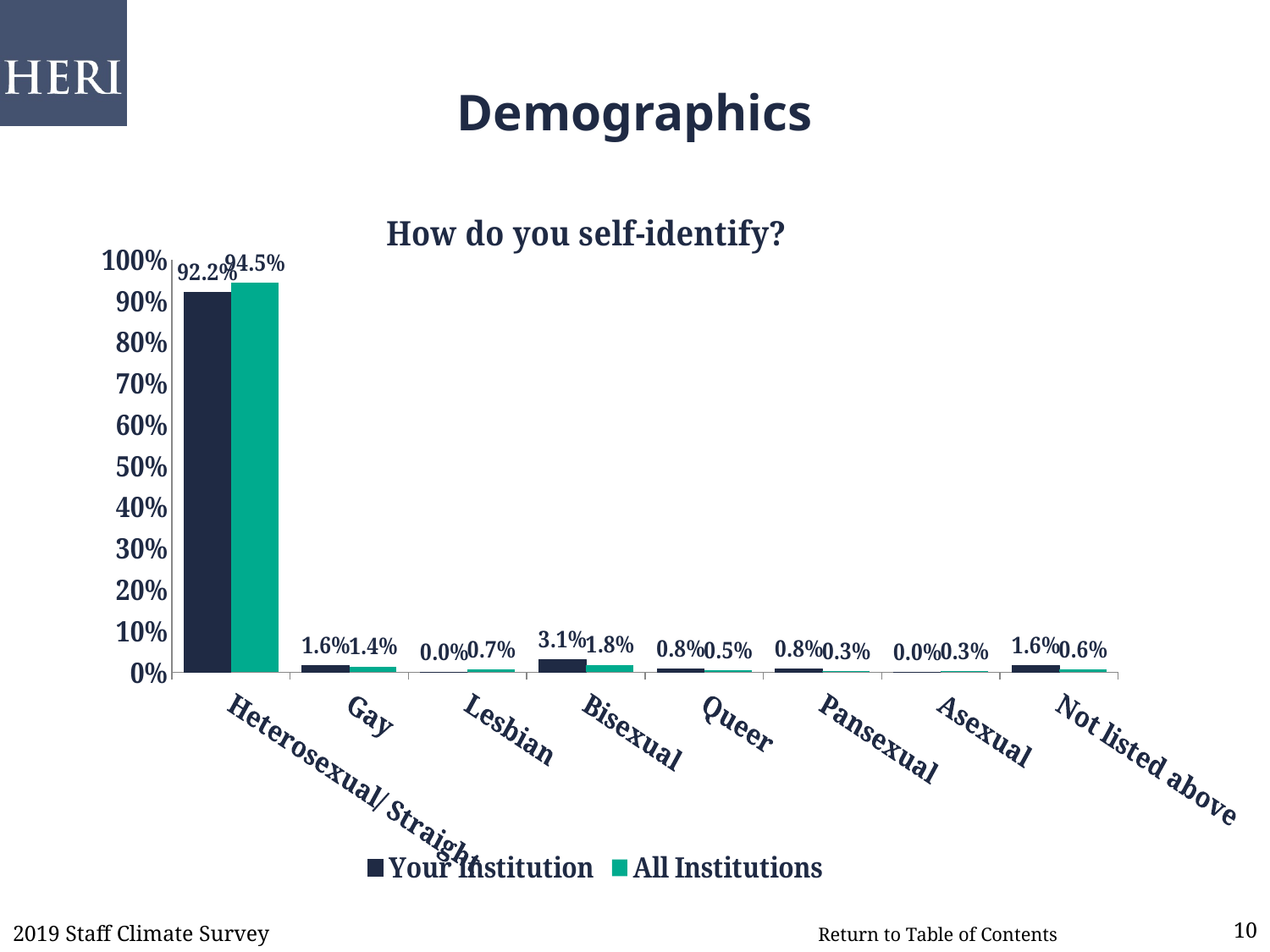
What is the value for All Institutions in the Pansexual category? 0.3% How many categories are shown on the x axis? 8 Is the value for Your Institution in the Heterosexual/Straight category greater or less than 90%? greater What is the value for Your Institution in the Heterosexual/Straight category? 92.2% Which category has the highest value for Your Institution? Heterosexual/Straight What kind of chart is shown on the slide? bar chart What is the value for Your Institution in the Lesbian category? 0.0% Which is larger for the Bisexual category, Your Institution or All Institutions? Your Institution How many series does the legend list? 2 What is the difference between the All Institutions and Your Institution values for Heterosexual/Straight? 2.3% What is the title of the chart? How do you self-identify? What is the value for All Institutions in the Bisexual category? 1.8%